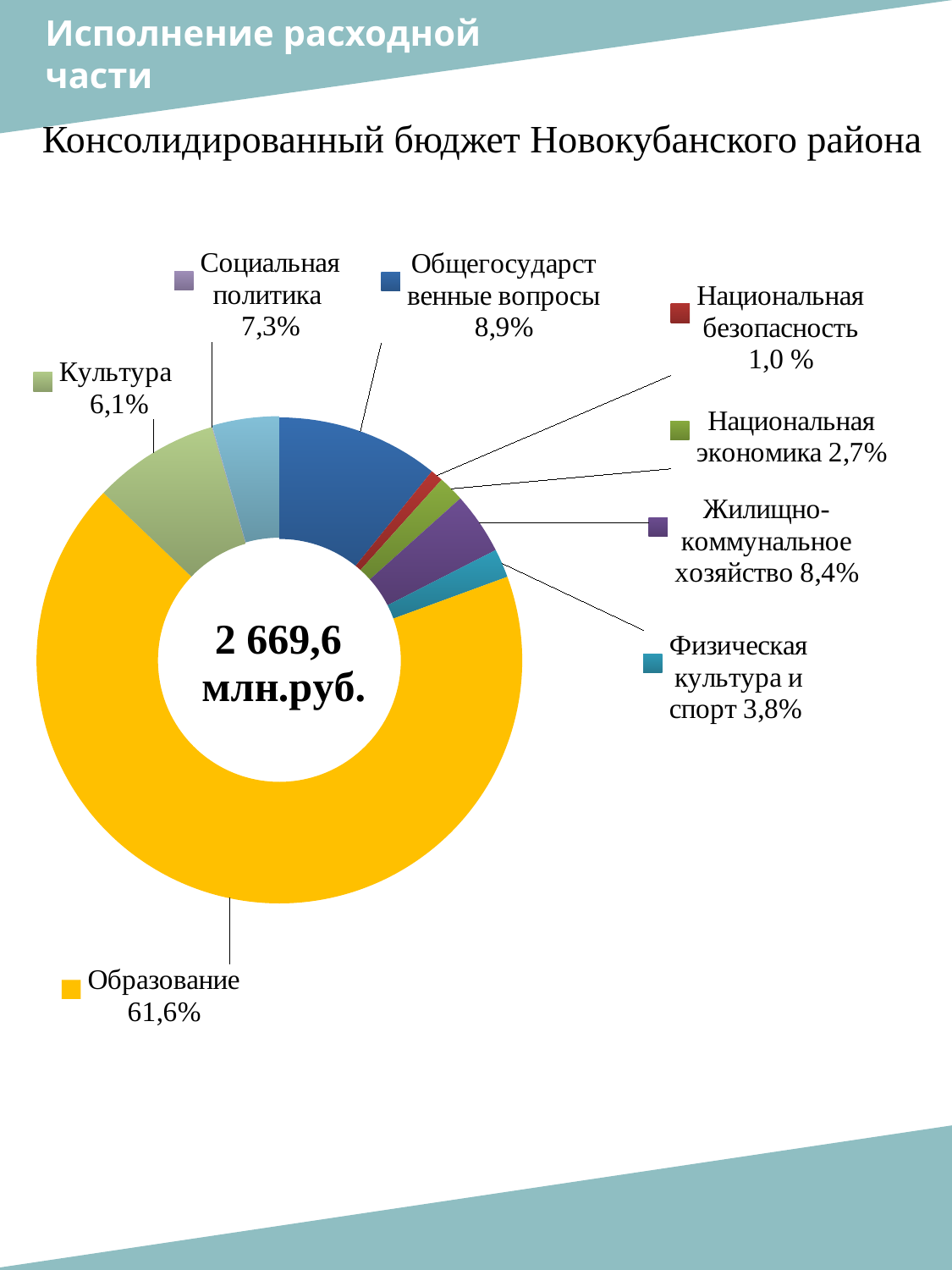
What is the difference in percentage points between Общегосударственные вопросы and Национальная экономика? 6,2 What share of the budget goes to Образование? 61,6% What share of the budget goes to Физическая культура и спорт? 3,8% What share of the budget goes to Общегосударственные вопросы? 8,9% Which category has the largest share of the budget? Образование What total amount is shown in the centre of the chart? 2 669,6 млн.руб. What type of chart is shown on the slide? Doughnut (pie) chart Which has a larger share: Социальная политика or Культура? Социальная политика What share of the budget goes to Жилищно-коммунальное хозяйство? 8,4% Which category has the smallest share of the budget? Национальная безопасность What share of the budget goes to Национальная безопасность? 1,0 % How many categories are shown in the chart? 8